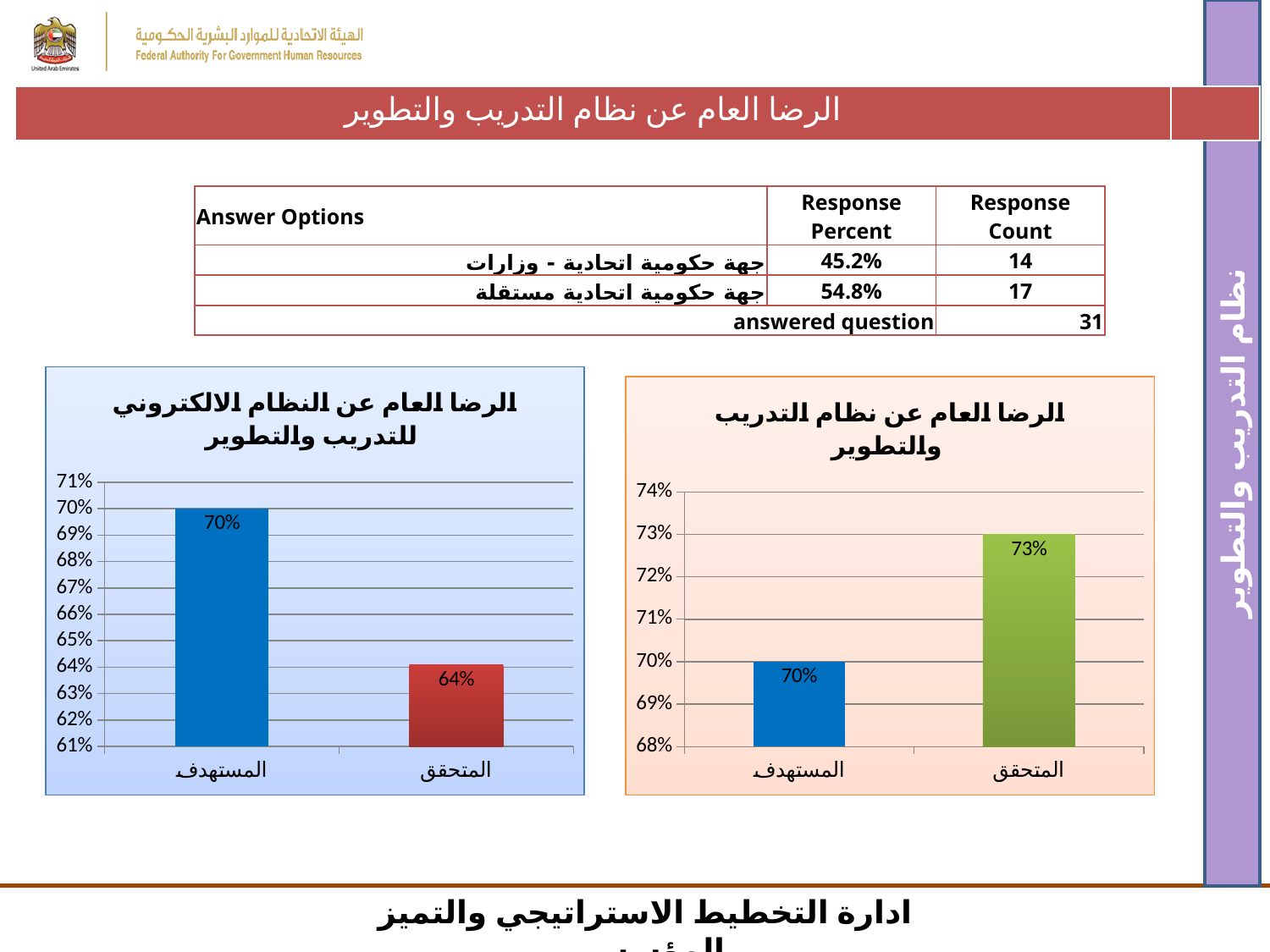
In the left chart, what is the difference between المستهدف and المتحقق? 6% In the right chart, is the value for المتحقق greater or less than 72%? greater In the left chart, which category has the higher value? المستهدف In the right chart, do the values rise or fall from المستهدف to المتحقق? Rise How many categories are shown in the left chart? 2 In the right chart, what is the difference between المتحقق and المستهدف? 3% In the right chart, which category has the lower value? المستهدف In the right chart (الرضا العام عن نظام التدريب والتطوير), what is the value for المستهدف? 70% In the left chart (الرضا العام عن النظام الالكتروني للتدريب والتطوير), what is the value for المتحقق? 64% In the right chart (الرضا العام عن نظام التدريب والتطوير), what is the value for المتحقق? 73% What type of chart is the right chart? Bar chart In the left chart (الرضا العام عن النظام الالكتروني للتدريب والتطوير), what is the value for المستهدف? 70%